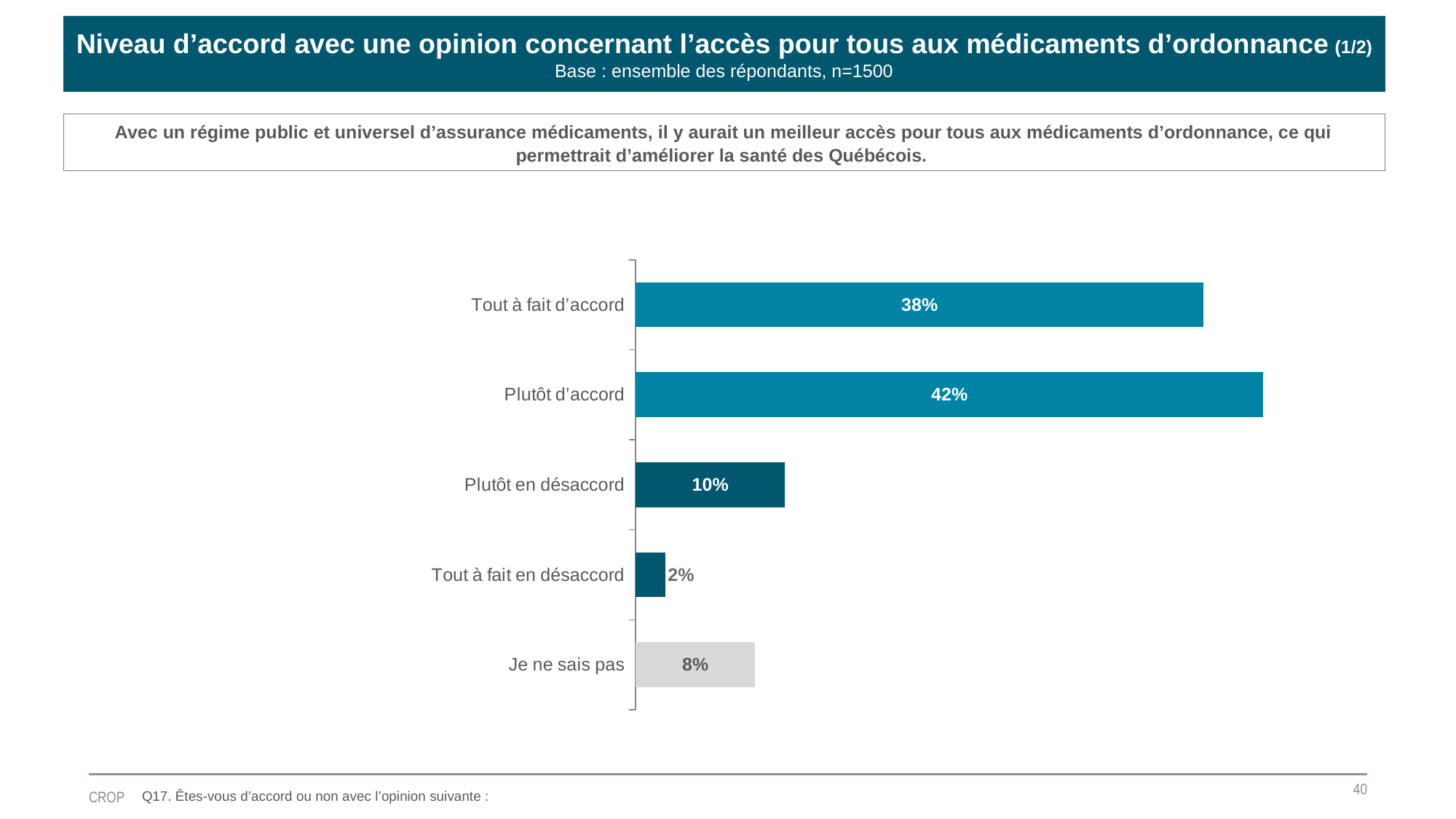
What kind of chart is shown on the slide? Bar chart What is the value shown for "Plutôt en désaccord"? 10% What is the difference between "Plutôt d'accord" and "Tout à fait d'accord"? 4 percentage points What is the combined value of "Tout à fait d'accord" and "Plutôt d'accord"? 80% What percentage of respondents answered "Tout à fait d'accord"? 38% What is the value shown for "Tout à fait en désaccord"? 2% Which is larger: the value for "Plutôt en désaccord" or the value for "Je ne sais pas"? Plutôt en désaccord How many response categories are shown in the chart? 5 Which response category has the highest value? Plutôt d'accord Which response category has the lowest value? Tout à fait en désaccord What percentage of respondents answered "Plutôt d'accord"? 42% What is the value shown for "Je ne sais pas"? 8%